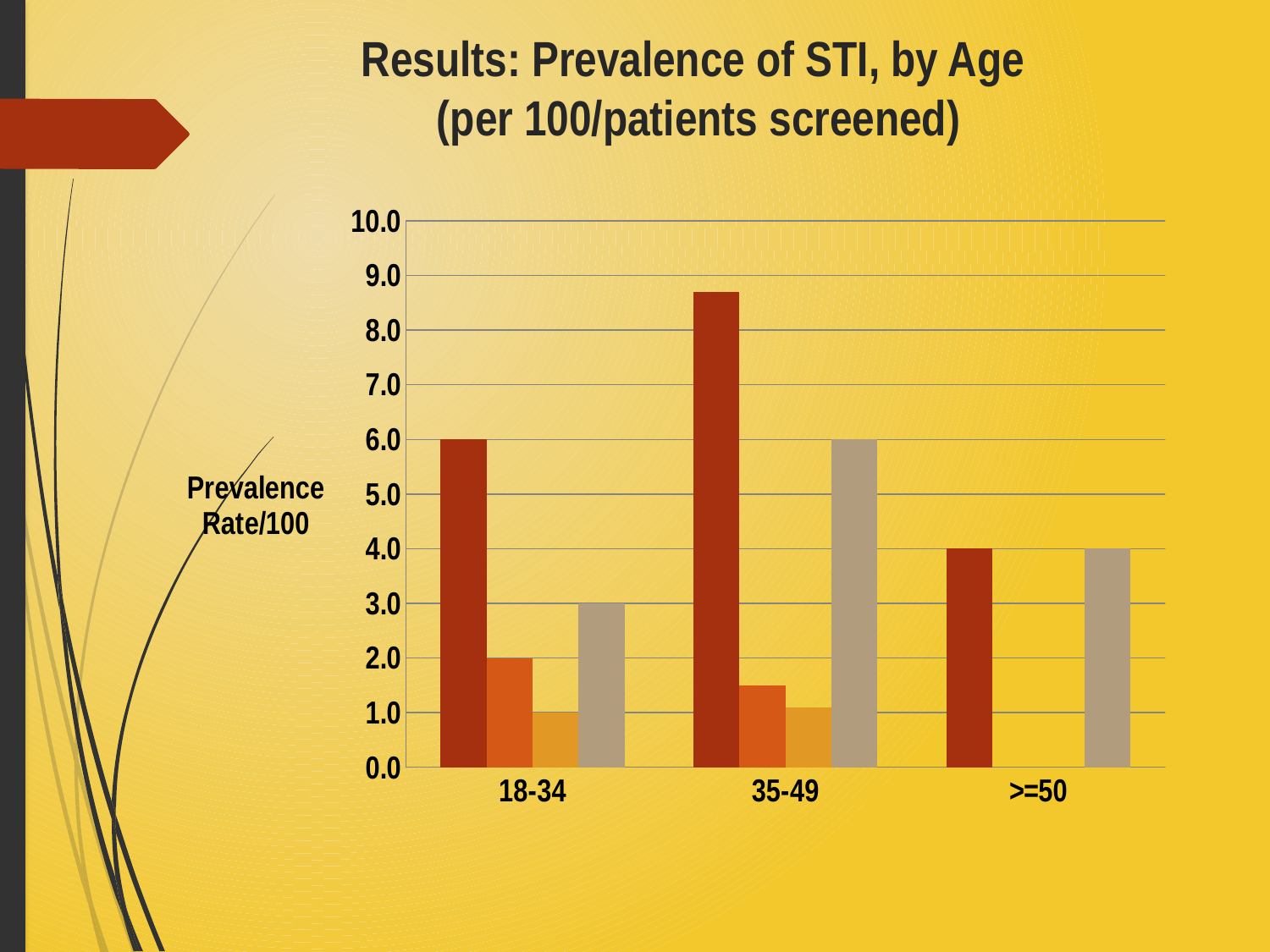
What is the value of the tan (grey-brown) bar in the 35-49 age group? 6.0 What is the value of the tan (grey-brown) bar in the 18-34 age group? 3.0 Is the tallest bar in the 35-49 age group greater or less than 8.0? greater What is the value of the tallest bar in the 18-34 age group? 6.0 Which age group has the larger dark red bar, 18-34 or >=50? 18-34 What is the label on the vertical axis of the chart? Prevalence Rate/100 How many bars are plotted for the >=50 age group? 2 How many age groups are shown on the x axis? 3 What is the value of the dark red bar in the >=50 age group? 4.0 Which age group contains the tallest bar in the chart? 35-49 What kind of chart is shown on the slide? bar chart What is the difference between the dark red bar and the tan bar in the 18-34 age group? 3.0